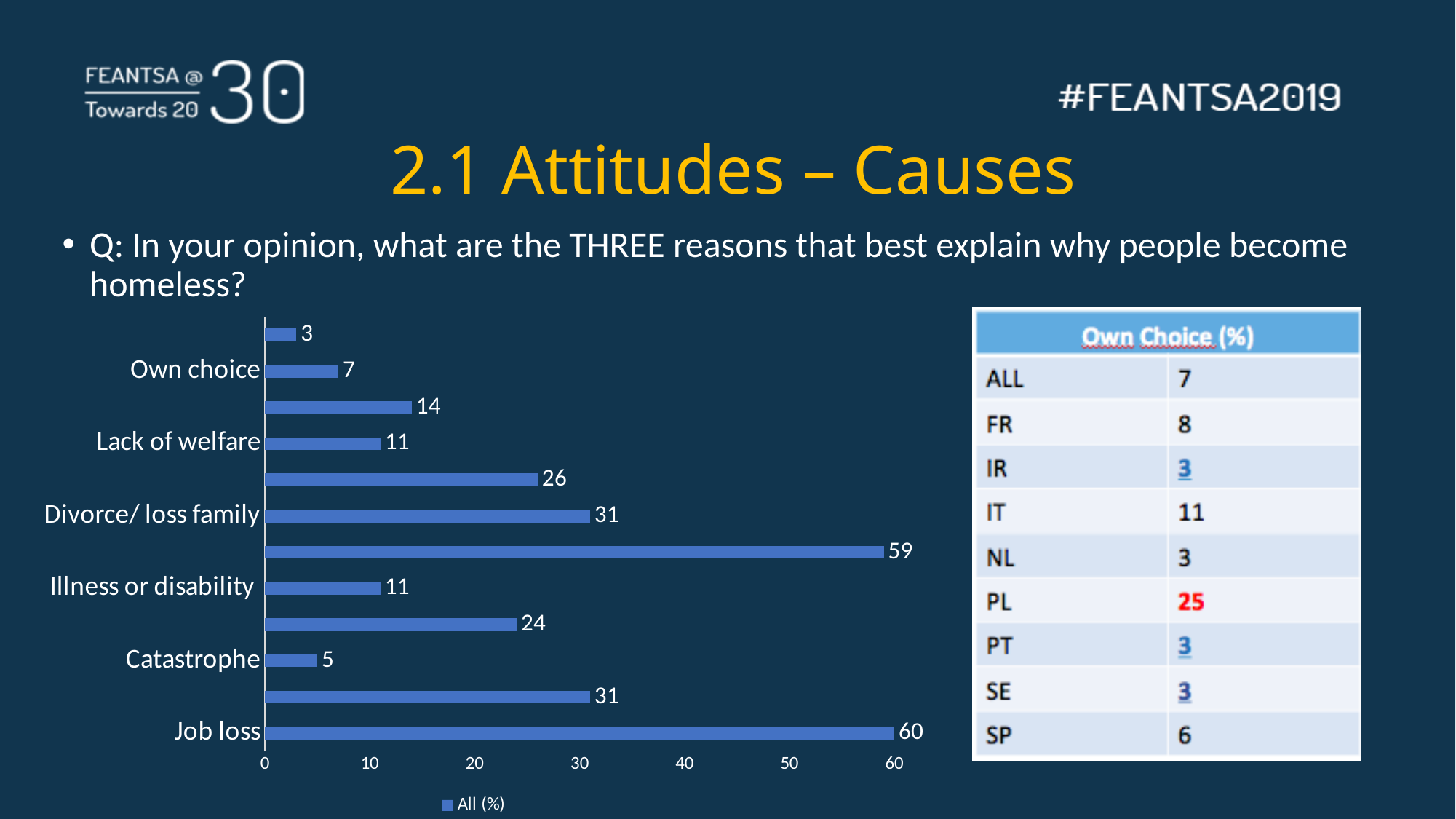
What kind of chart is shown on the slide? Bar chart Which labelled category has the highest value? Job loss What is the value for Job loss? 60 What is the value for Catastrophe? 5 How many series does the legend list? 1 What is the difference between the values for Job loss and Own choice? 53 What is the value for Own choice? 7 Which labelled category has the lowest value? Catastrophe What is the value for Divorce/ loss family? 31 Which is larger, the value for Divorce/ loss family or the value for Catastrophe? Divorce/ loss family How many bars are plotted in the chart? 12 What is the value for Lack of welfare? 11